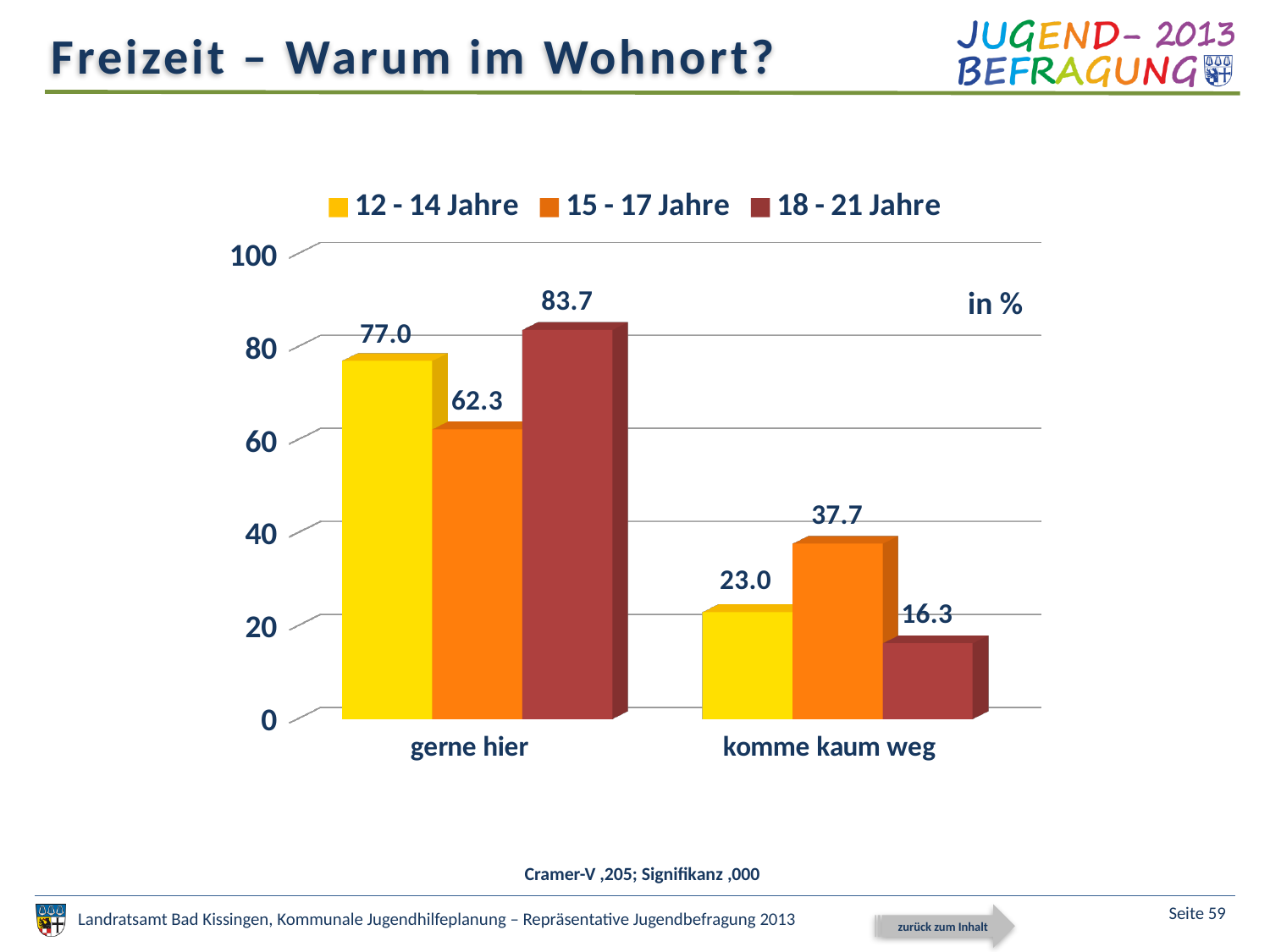
What is the value for the 12 - 14 Jahre series in the 'gerne hier' category? 77.0 What kind of chart is shown on the slide? Bar chart What unit is indicated for the values in the chart? in % What is the value for the 18 - 21 Jahre series in the 'komme kaum weg' category? 16.3 What is the difference between the 15 - 17 Jahre and 12 - 14 Jahre values in the 'komme kaum weg' category? 14.7 Which age group has the highest value in the 'gerne hier' category? 18 - 21 Jahre How many series does the legend list? 3 What is the value for the 15 - 17 Jahre series in the 'komme kaum weg' category? 37.7 Which is larger: the 12 - 14 Jahre value for 'gerne hier' or the 15 - 17 Jahre value for 'gerne hier'? 12 - 14 Jahre What is the difference between the 18 - 21 Jahre and 15 - 17 Jahre values in the 'gerne hier' category? 21.4 How many categories are shown on the x axis? 2 Which age group has the lowest value in the 'komme kaum weg' category? 18 - 21 Jahre